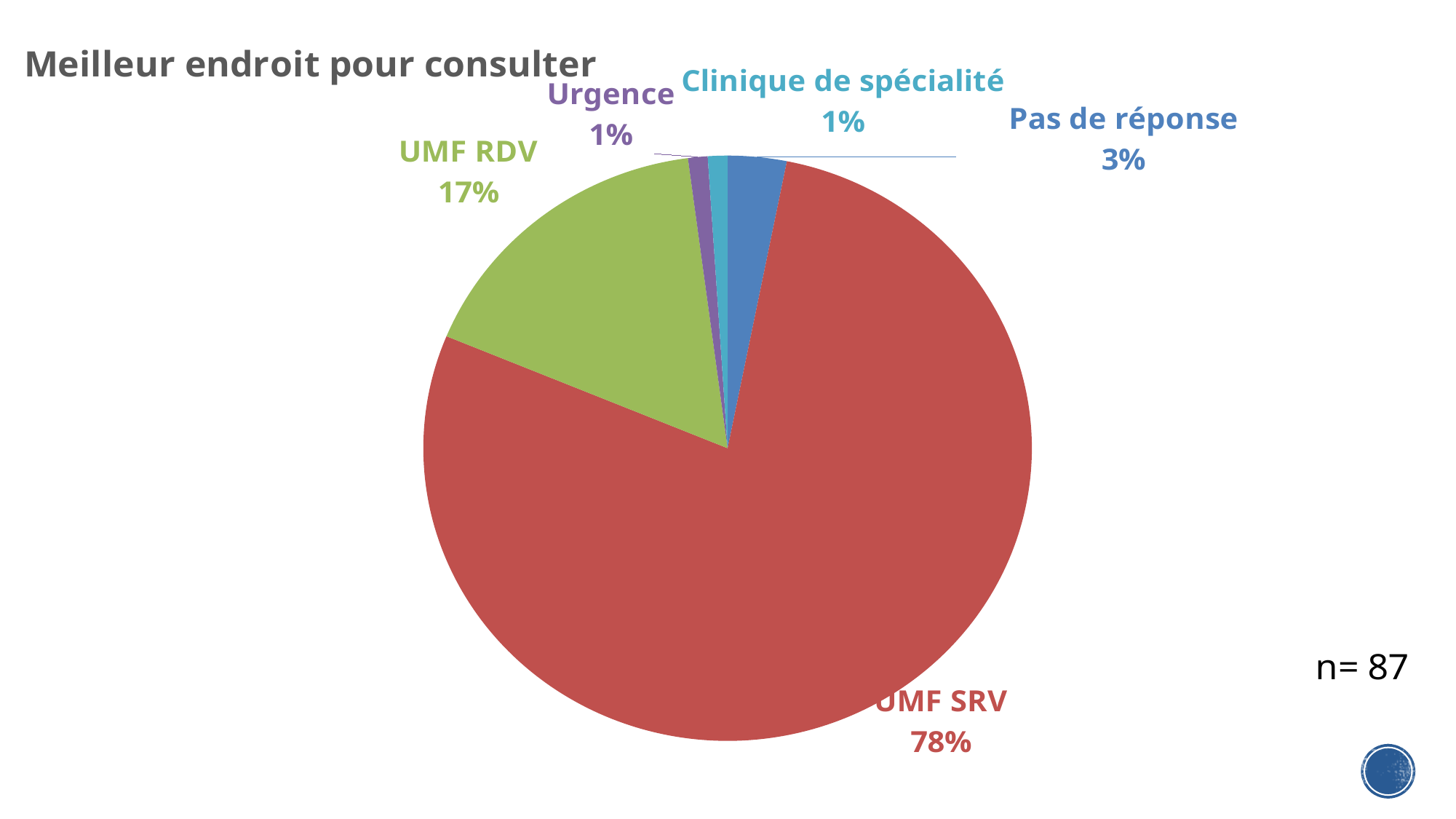
What is the value shown for Clinique de spécialité? 1% What is the value shown for Pas de réponse? 3% What is the value shown for Urgence? 1% What share of the pie does UMF RDV represent? 17% Which is larger, the share for Pas de réponse or the share for Urgence? Pas de réponse What is the title of the chart? Meilleur endroit pour consulter What is the difference in percentage points between UMF SRV and UMF RDV? 61 What is the difference in percentage points between UMF RDV and Pas de réponse? 14 What share of the pie does UMF SRV represent? 78% Which category has the largest slice of the pie? UMF SRV How many categories are shown in the pie chart? 5 What kind of chart is shown on the slide? Pie chart